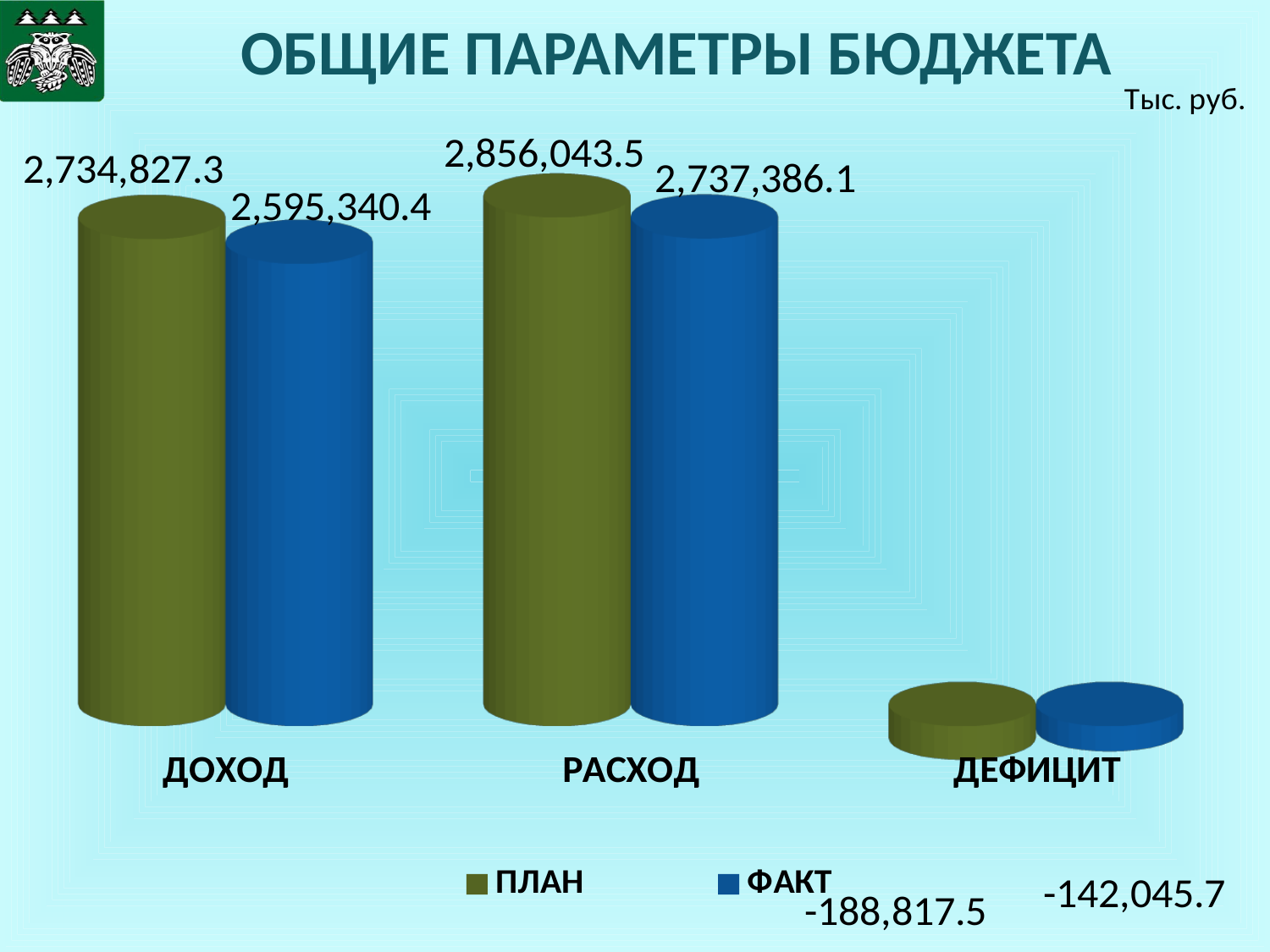
Which is larger for РАСХОД, the ПЛАН value or the ФАКТ value? ПЛАН What is the ФАКТ value for ДОХОД? 2,595,340.4 How many series does the legend list? 2 What is the ПЛАН value for ДОХОД? 2,734,827.3 What is the ПЛАН value for ДЕФИЦИТ? -188,817.5 What is the ФАКТ value for ДЕФИЦИТ? -142,045.7 What kind of chart is shown on the slide? Bar chart What is the difference between the ПЛАН and ФАКТ values for ДОХОД? 139,486.9 What is the ПЛАН value for РАСХОД? 2,856,043.5 Which category has the lowest ФАКТ value? ДЕФИЦИТ What is the ФАКТ value for РАСХОД? 2,737,386.1 Which category has the highest ПЛАН value? РАСХОД